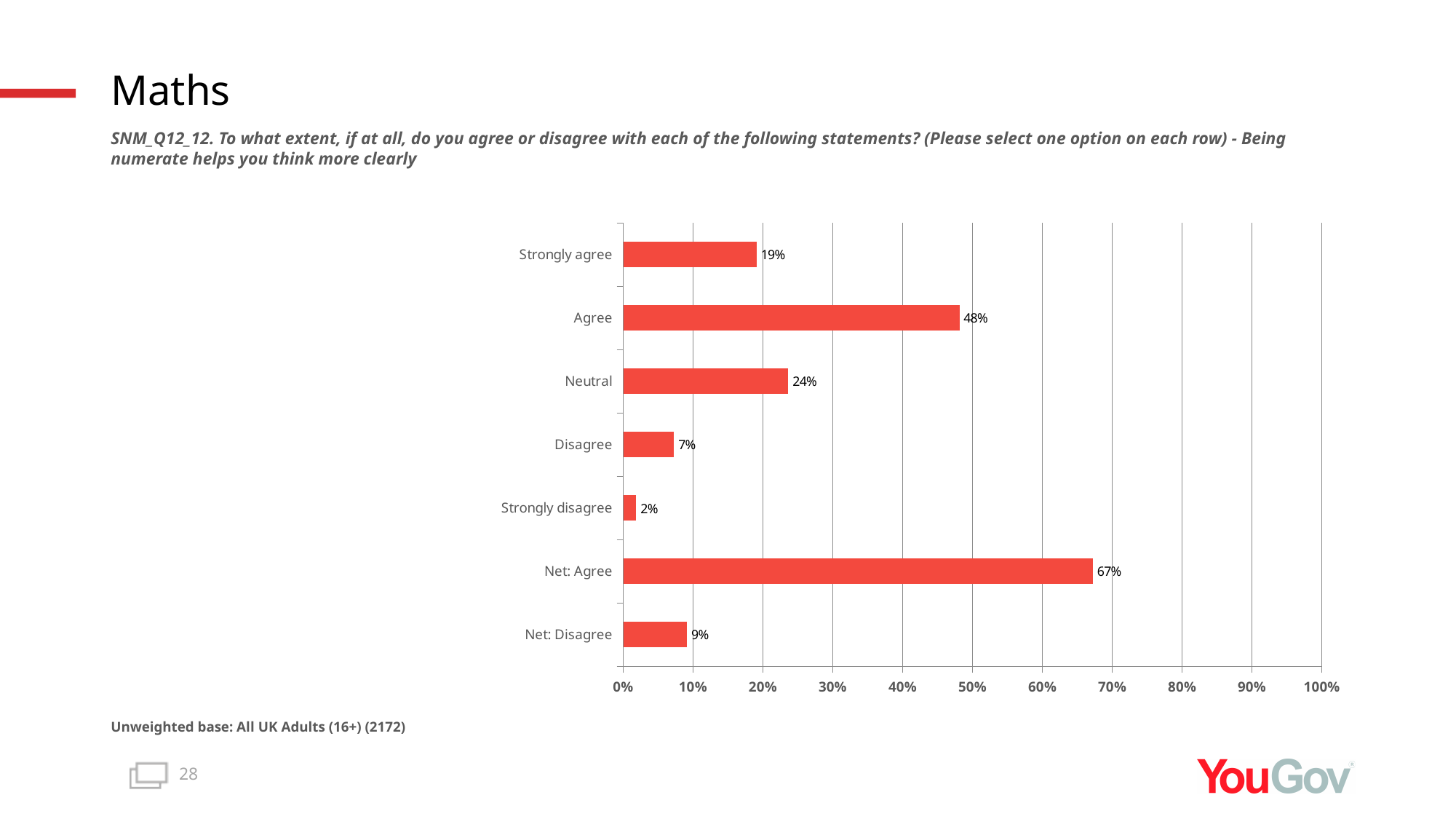
Which category has the lowest value? Strongly disagree What percentage of respondents selected 'Agree'? 48% Is the value for 'Disagree' greater or less than 10%? less What is the value for 'Neutral'? 24% What is the value for 'Strongly disagree'? 2% What is the value for 'Net: Agree'? 67% What is the difference between 'Net: Agree' and 'Net: Disagree'? 58% Which category has the highest value? Net: Agree What kind of chart is shown on the slide? bar chart What is the difference between 'Agree' and 'Strongly agree'? 29% How many categories are shown on the chart? 7 Which is larger, 'Neutral' or 'Strongly agree'? Neutral